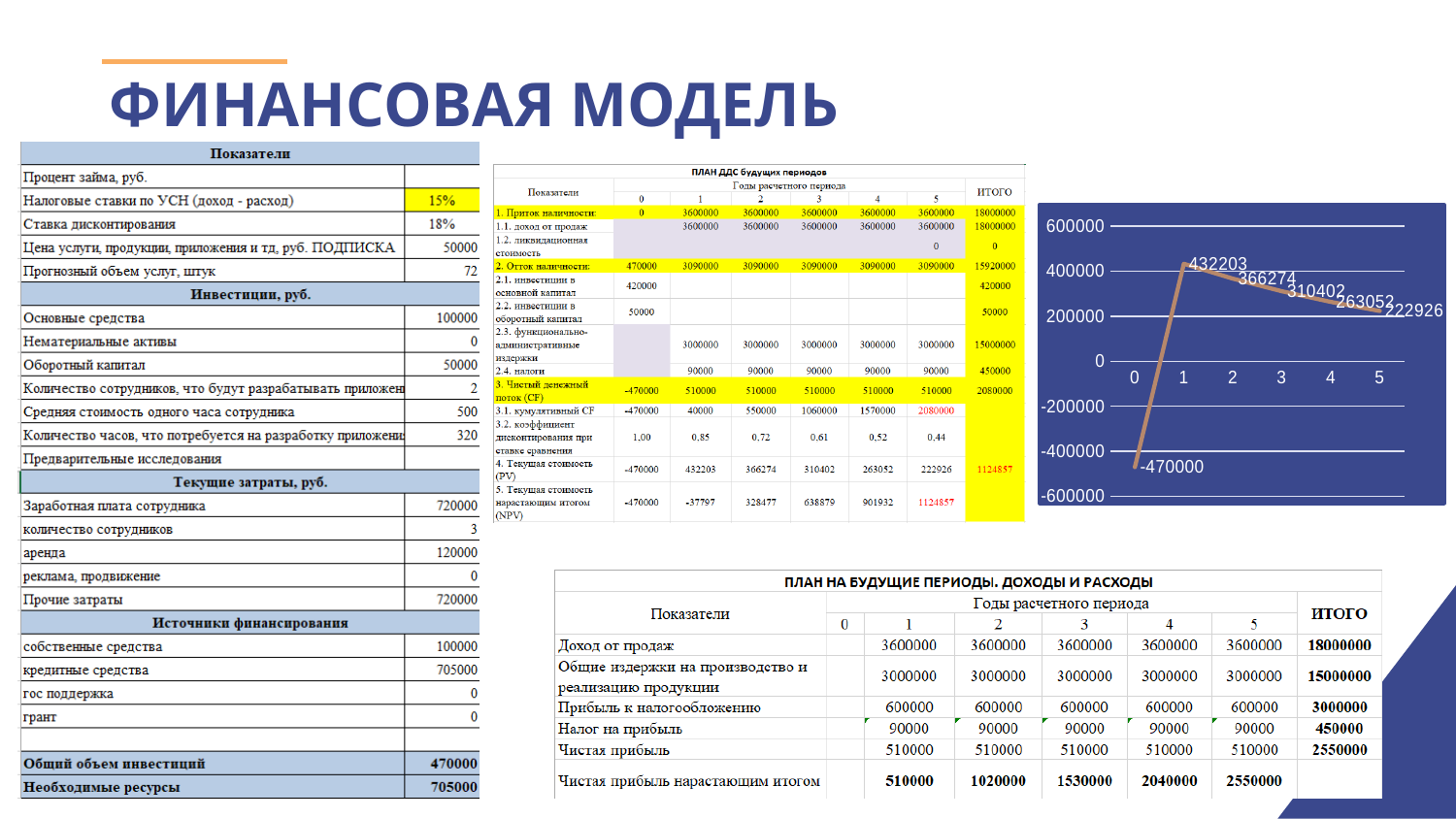
Is the value at x = 2 on the line chart greater or less than 400000? less At which x value does the line chart reach its highest point? 1 What is the value plotted at x = 5 on the line chart? 222926 What is the value plotted at x = 3 on the line chart? 310402 Which is larger on the line chart: the value at x = 4 or the value at x = 5? x = 4 How many data points are plotted on the line chart? 6 What is the difference between the values at x = 1 and x = 2 on the line chart? 65929 What is the value plotted at x = 0 on the line chart? -470000 What is the value plotted at x = 1 on the line chart? 432203 At which x value does the line chart reach its lowest point? 0 What type of chart is shown on the slide? line chart From x = 1 to x = 5, do the values on the line chart rise or fall? fall